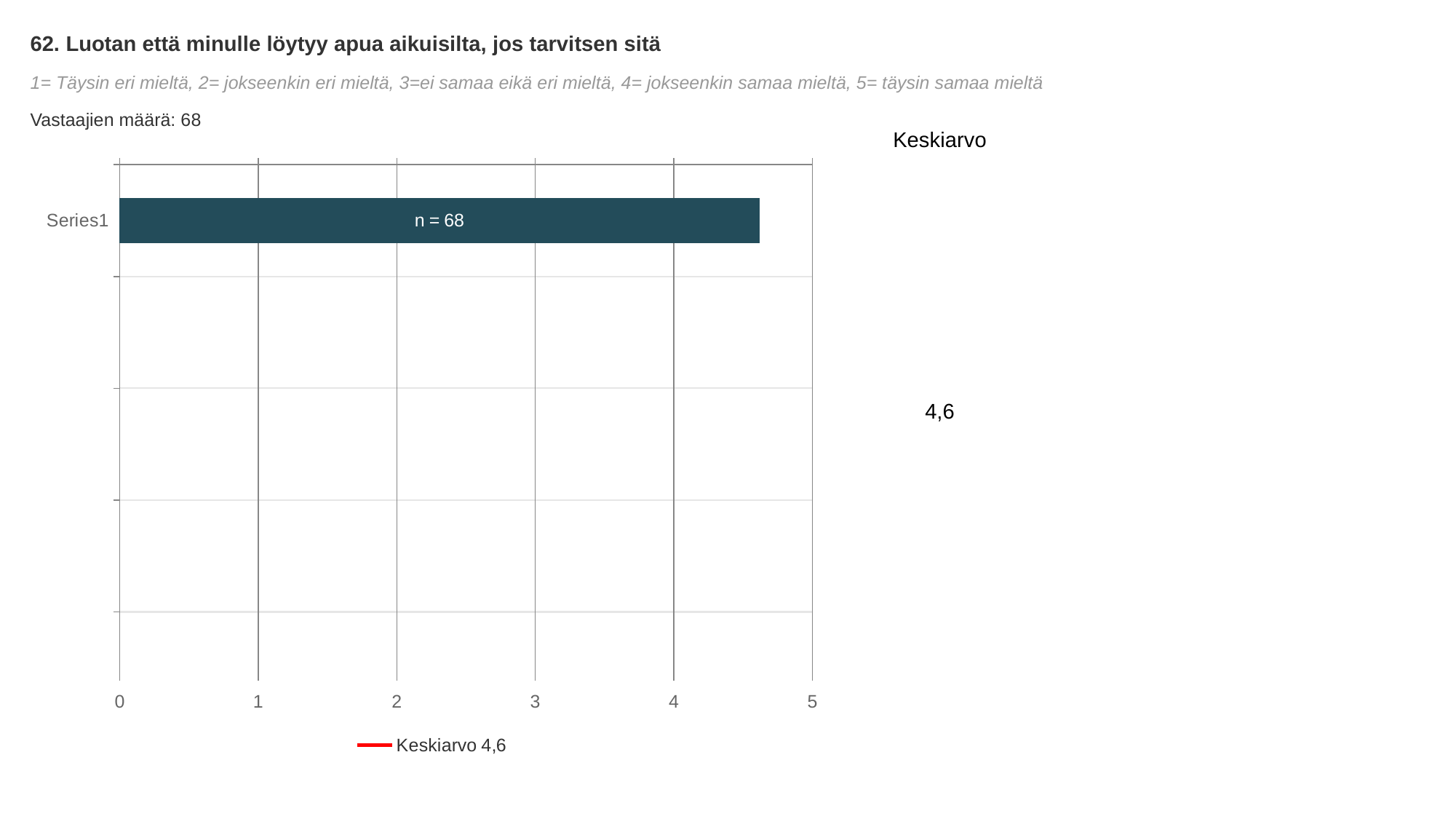
What is the Keskiarvo (mean) value shown on the slide? 4,6 Is the value for Series1 greater or less than 5? less What does the legend entry below the chart say? Keskiarvo 4,6 What is the category label of the single bar in the chart? Series1 How many respondents (Vastaajien määrä) are reported on the slide? 68 What data label is printed on the Series1 bar? n = 68 Is the value for Series1 greater or less than 4? greater What is the maximum value shown on the x axis? 5 What kind of chart is shown on the slide? bar chart How many bars are plotted in the chart? 1